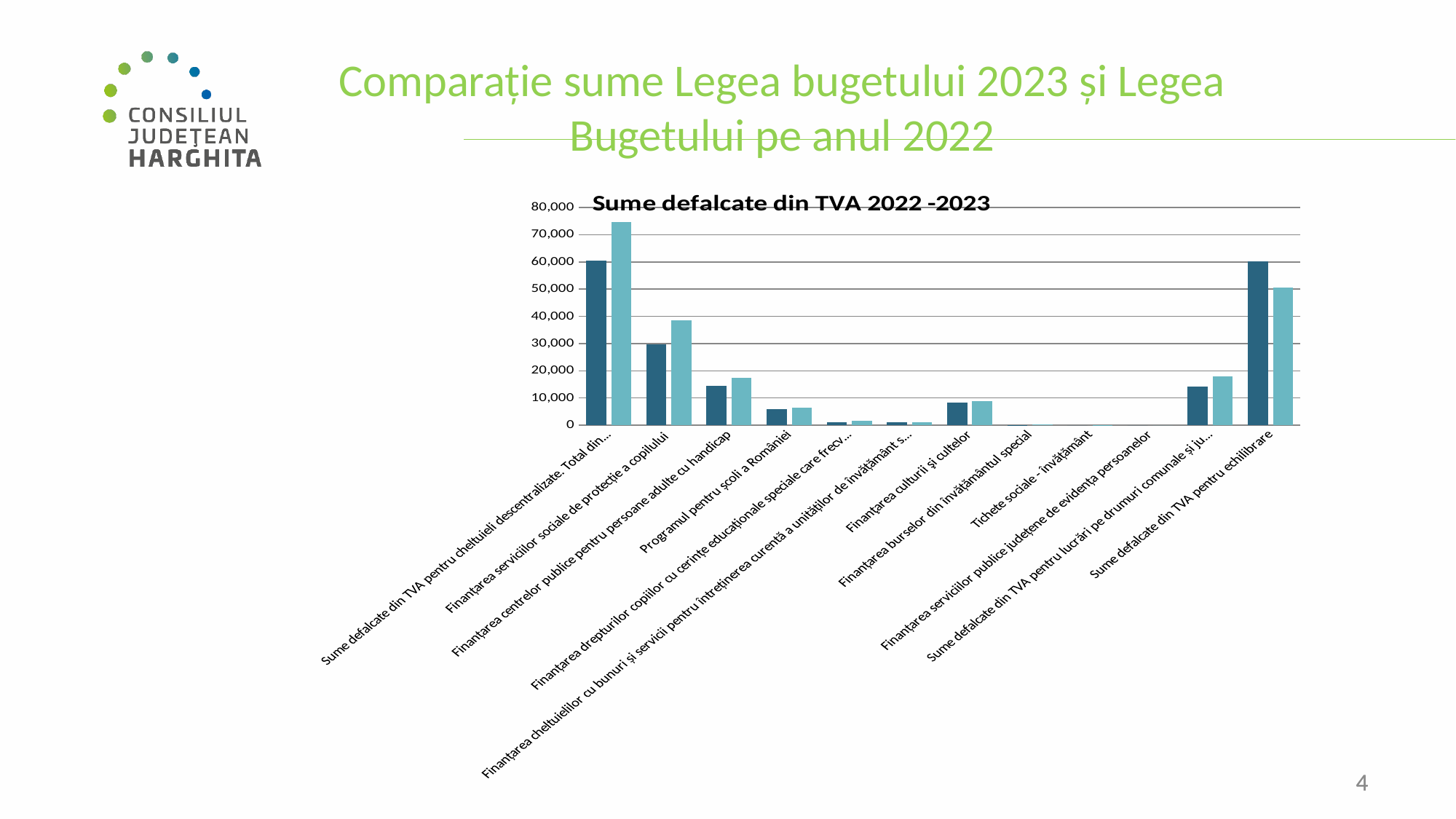
How many categories are shown on the x axis of the chart? 12 For 'Sume defalcate din TVA pentru echilibrare', which bar is taller, the dark-coloured one or the light-coloured one? The dark-coloured one Is the value of the light-coloured bar for 'Finanțarea serviciilor sociale de protecție a copilului' greater or less than 40,000? less What is the title of the chart? Sume defalcate din TVA 2022 -2023 For 'Finanțarea serviciilor sociale de protecție a copilului', which bar is taller, the dark-coloured one or the light-coloured one? The light-coloured one What kind of chart is shown on the slide? Bar chart Is the value of the dark-coloured bar for 'Sume defalcate din TVA pentru cheltuieli descentralizate. Total din...' greater or less than 50,000? greater Is the value of the dark-coloured bar for 'Finanțarea centrelor publice pentru persoane adulte cu handicap' greater or less than 20,000? less How many bars are plotted for each category in the chart? 2 Which category has the tallest bar in the chart? Sume defalcate din TVA pentru cheltuieli descentralizate. Total din...